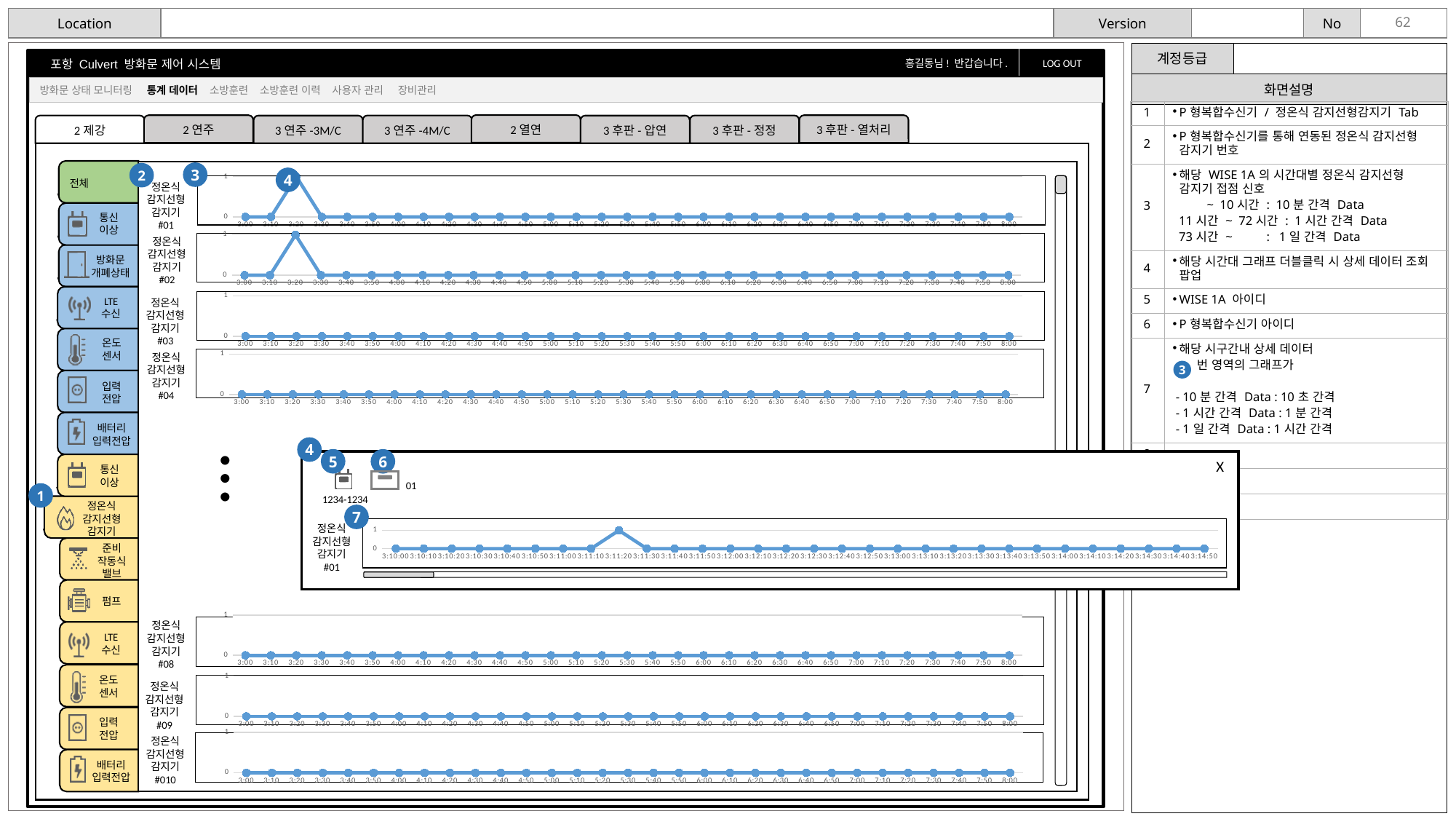
In the popup chart for 정온식 감지선형 감지기 #01, what is the value at 3:12:00? 0 In the chart for 정온식 감지선형 감지기 #01, which is larger, the value at 3:20 or the value at 3:30? 3:20 In the chart for 정온식 감지선형 감지기 #03, what is the highest value plotted? 0 What kind of chart is used for 정온식 감지선형 감지기 #01? line chart In the chart for 정온식 감지선형 감지기 #02, what is the value at 3:20? 1 In the chart for 정온식 감지선형 감지기 #04, do the values rise, fall, or stay flat across the x axis? stay flat In the chart for 정온식 감지선형 감지기 #01, what is the value at 3:00? 0 In the chart for 정온식 감지선형 감지기 #01, what is the difference between the value at 3:20 and the value at 3:00? 1 In the chart for 정온식 감지선형 감지기 #01, at which time is the value highest? 3:20 What are the first and last x-axis labels on the chart for 정온식 감지선형 감지기 #08? 3:00 and 8:00 In the popup chart for 정온식 감지선형 감지기 #01 (with second-level time labels), at which time does the value reach 1? 3:11:20 In the chart for 정온식 감지선형 감지기 #01, what is the value at 3:20? 1